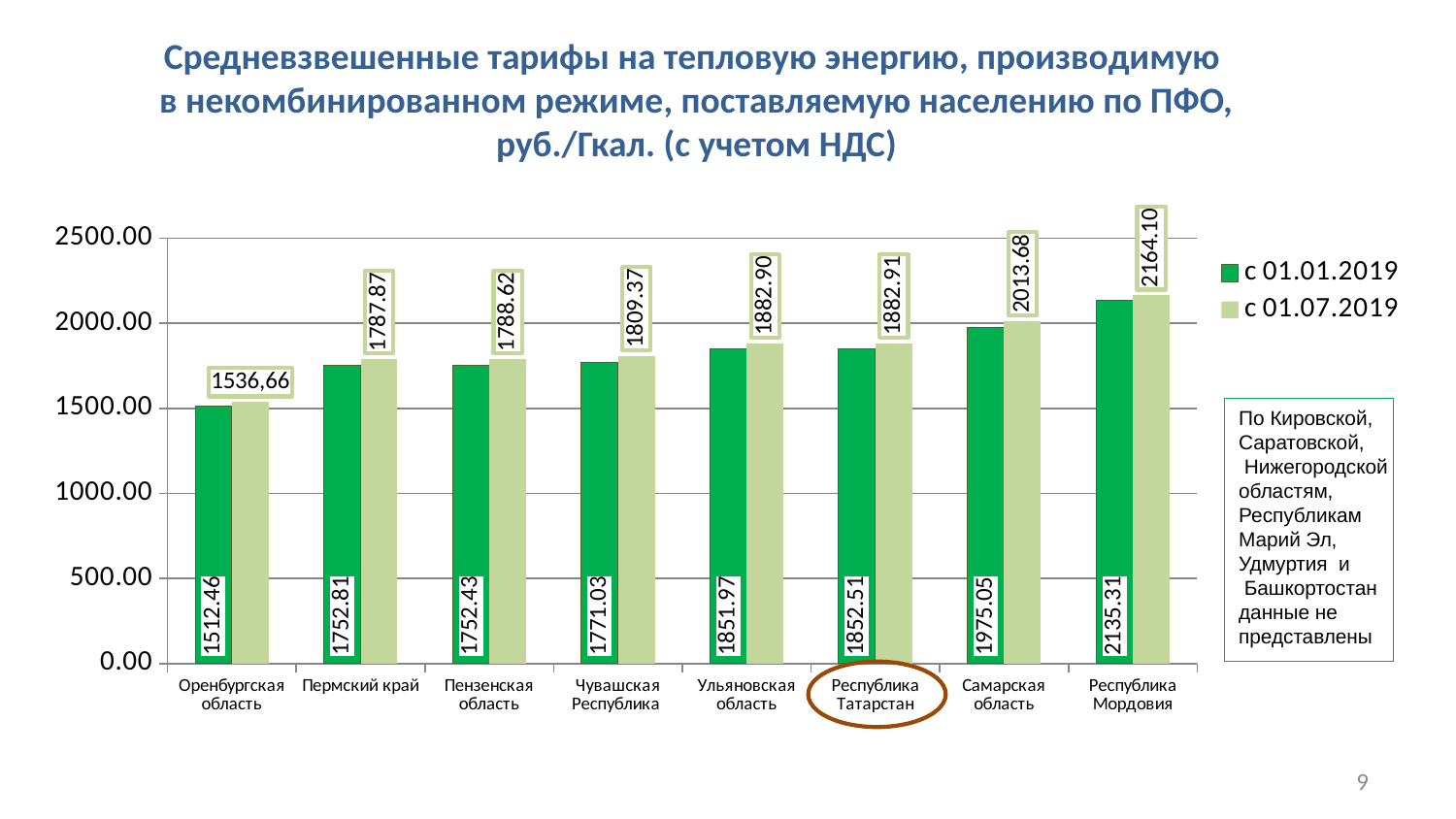
How many series does the legend list? 2 What is the difference between the с 01.07.2019 and с 01.01.2019 values for Республика Мордовия? 28.79 What is the value for Самарская область in the series с 01.01.2019? 1975.05 Which is larger in the series с 01.07.2019: Самарская область or Республика Мордовия? Республика Мордовия Which region has the highest value in the series с 01.07.2019? Республика Мордовия Which legend entry is shown in dark green? с 01.01.2019 How many regions are shown on the x axis of the chart? 8 What is the value for Оренбургская область in the series с 01.07.2019? 1536,66 What type of chart is shown on the slide? bar chart Which region has the lowest value in the series с 01.01.2019? Оренбургская область What is the value for Республика Татарстан in the series с 01.07.2019? 1882.91 Do the values in the series с 01.01.2019 rise or fall from left to right along the x axis? rise